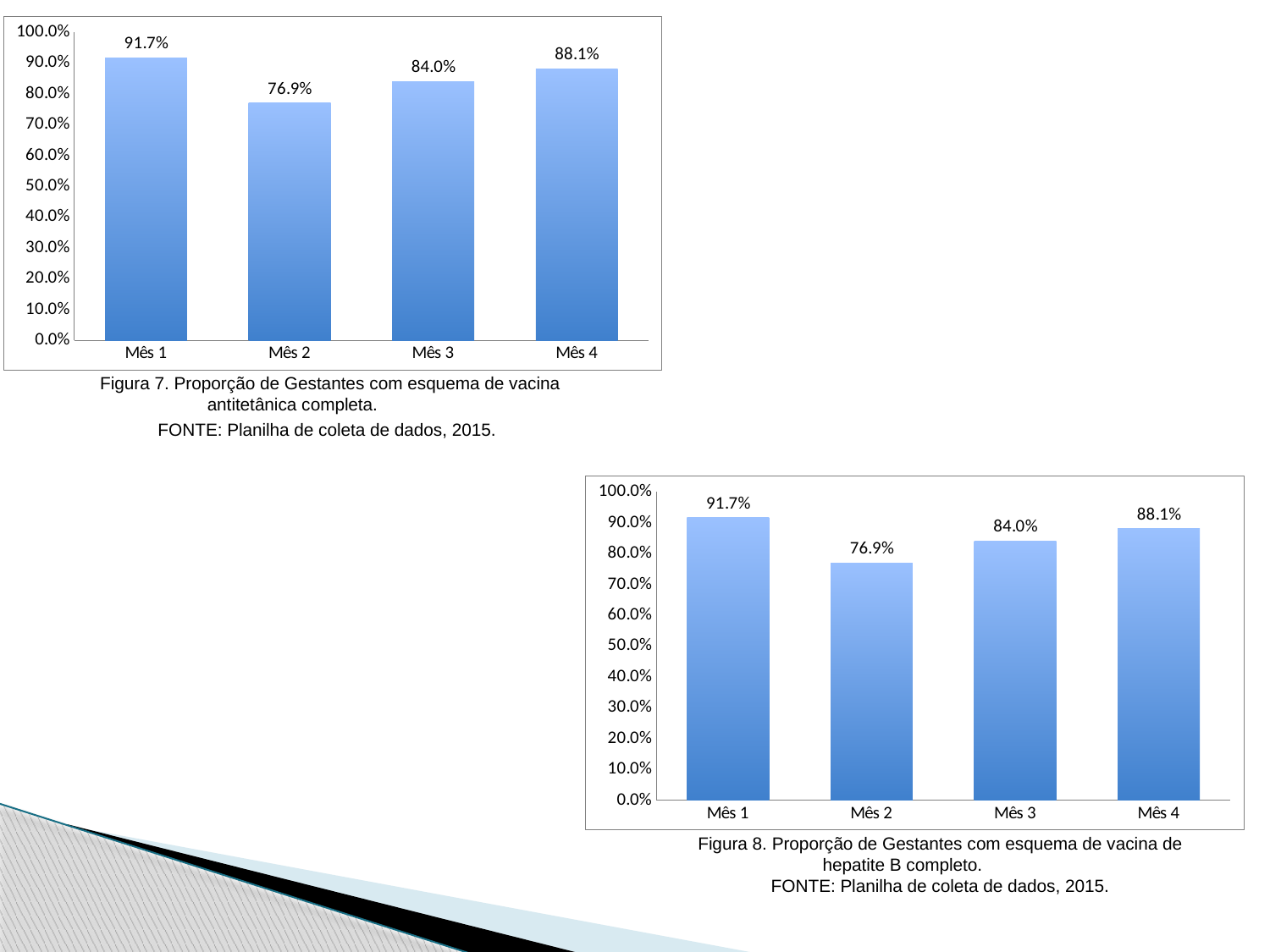
In the Figura 7 chart (top left), is the value for Mês 2 greater or less than 80.0%? less What is the caption of the chart at the bottom right of the slide? Figura 8. Proporção de Gestantes com esquema de vacina de hepatite B completo. In the Figura 7 chart (top left), what is the difference between the values for Mês 1 and Mês 2? 14.8% What kind of chart is the Figura 7 chart (top left)? bar chart In the Figura 8 chart (bottom right), which month has the lowest value? Mês 2 In the Figura 8 chart (bottom right), which is larger, the value for Mês 3 or the value for Mês 4? Mês 4 In the Figura 7 chart (top left), what is the value for Mês 1? 91.7% How many months are shown on the x axis of the Figura 8 chart (bottom right)? 4 In the Figura 7 chart (top left), which month has the highest value? Mês 1 In the Figura 8 chart (bottom right), what is the value for Mês 3? 84.0% In the Figura 7 chart (top left), what is the value for Mês 2? 76.9% In the Figura 8 chart (bottom right), what is the value for Mês 4? 88.1%